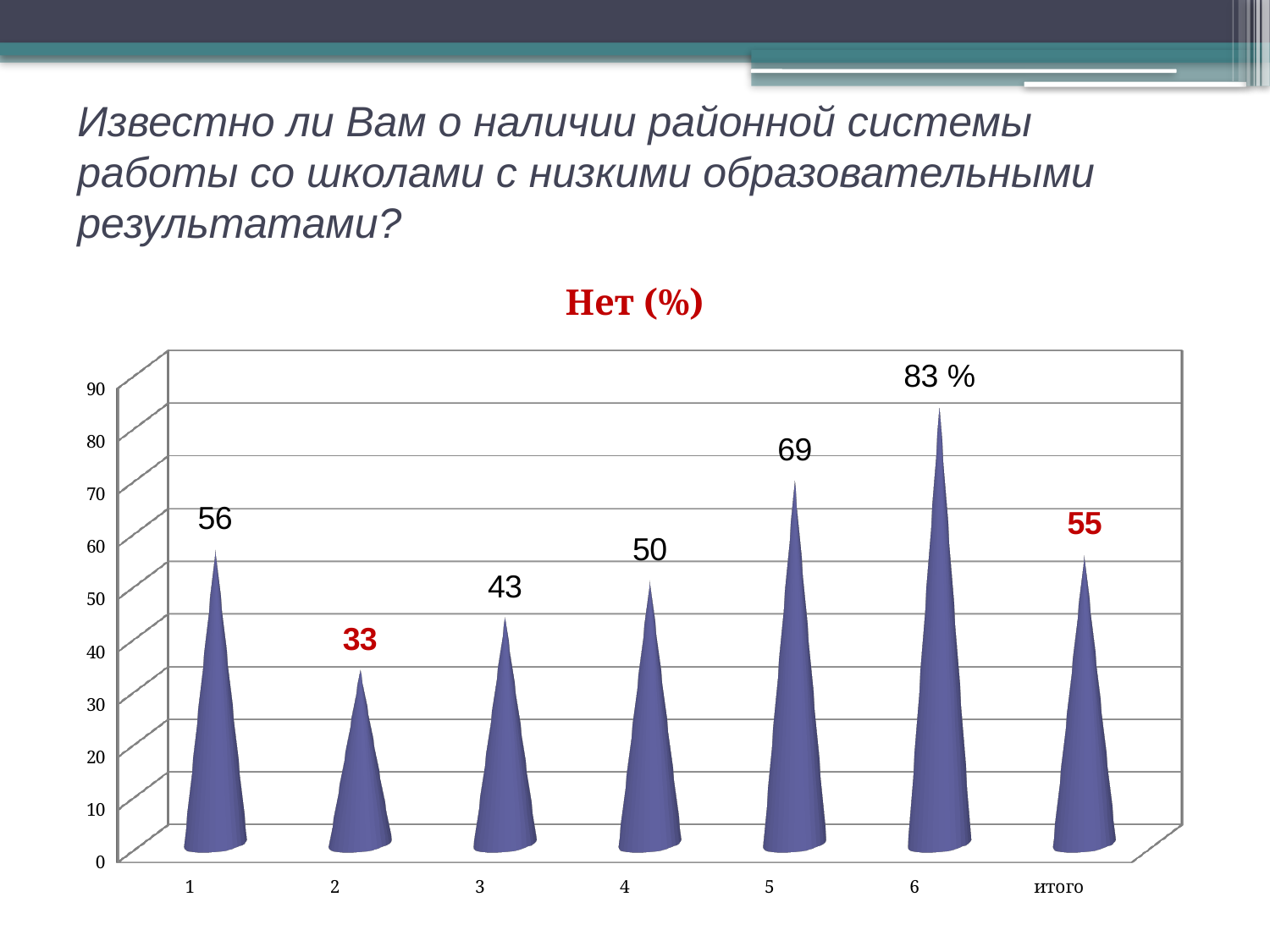
What is the title of the chart? Нет (%) What kind of chart is shown on the slide? bar chart What is the difference between the values for category 5 and category 3? 26 What is the value for category 1? 56 What is the value for "итого"? 55 How many categories are shown on the x axis? 7 What is the value for category 2? 33 Which category has the highest value? 6 Which category has the lowest value? 2 Is the value for category 5 greater or less than 60? greater What is the value for category 6? 83 % Which is larger, the value for category 4 or the value for category 1? category 1